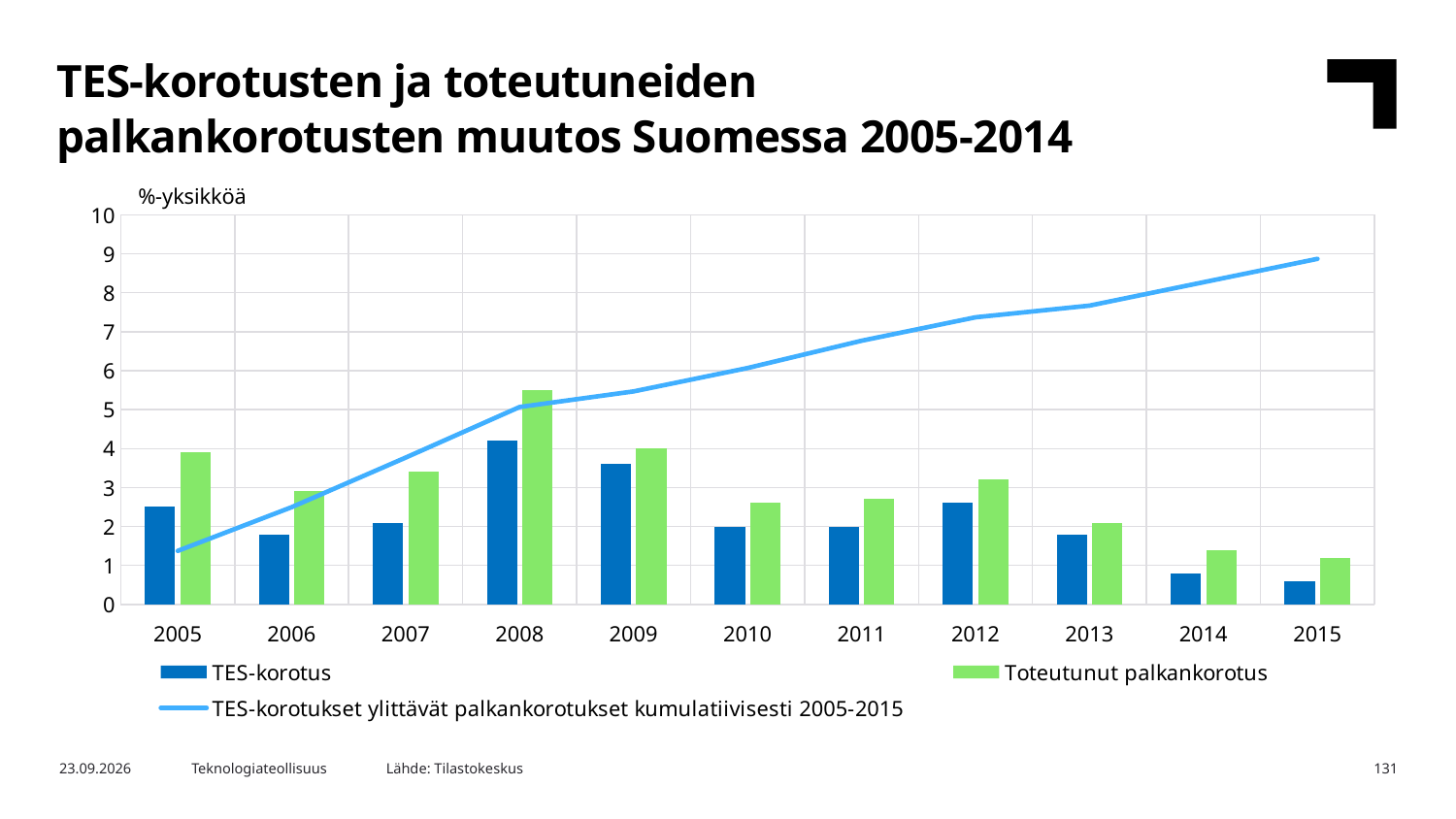
Does the cumulative line rise or fall from 2005 to 2015? rises In which year is the TES-korotus bar the highest? 2008 What unit label is shown above the vertical axis of the chart? %-yksikköä In which year is the TES-korotus bar the lowest? 2015 Which is larger, the TES-korotus value for 2005 or for 2006? 2005 In which year is the Toteutunut palkankorotus bar the highest? 2008 How many years are shown on the x axis of the chart? 11 How many series does the chart's legend list? 3 In which year is the Toteutunut palkankorotus bar the lowest? 2015 Is the value of the cumulative line (TES-korotukset ylittävät palkankorotukset kumulatiivisesti 2005-2015) in 2015 greater or less than 8? greater What kind of chart is shown on the slide? bar chart combined with a line Is the Toteutunut palkankorotus value for 2008 greater or less than 5? greater